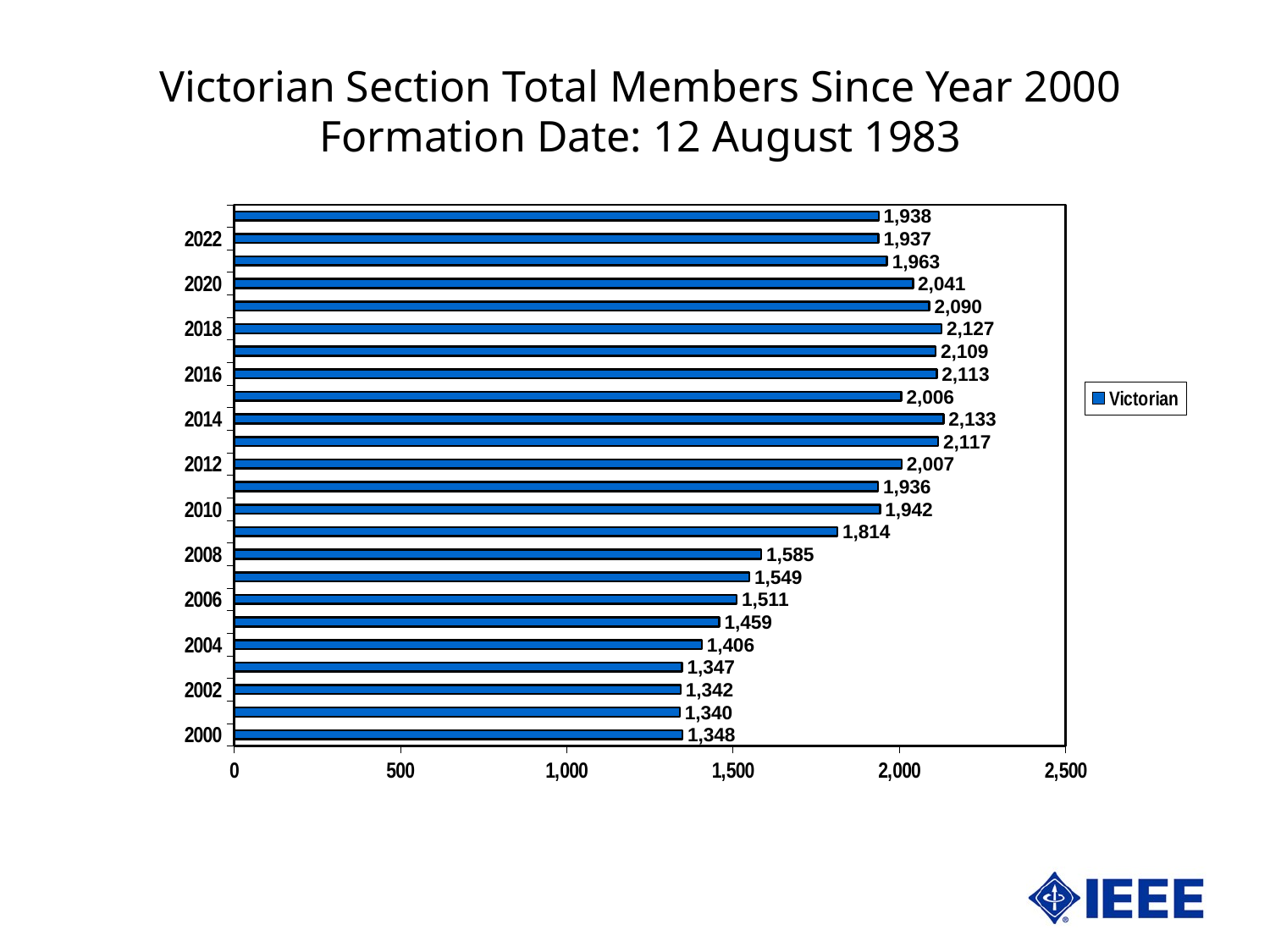
What is the value for 2014? 2,133 What is the value for 2022? 1,937 What is the value for 2008? 1,585 How many bars are plotted on the chart? 24 What is the value for 2000? 1,348 What series name is listed in the legend? Victorian Is the value for 2006 greater or less than 1,500? greater What kind of chart is shown? bar chart What is the difference between the values for 2014 and 2000? 785 Which is larger, the value for 2010 or the value for 2020? 2020 Which year has the highest value? 2014 What is the lowest value shown on the chart? 1,340